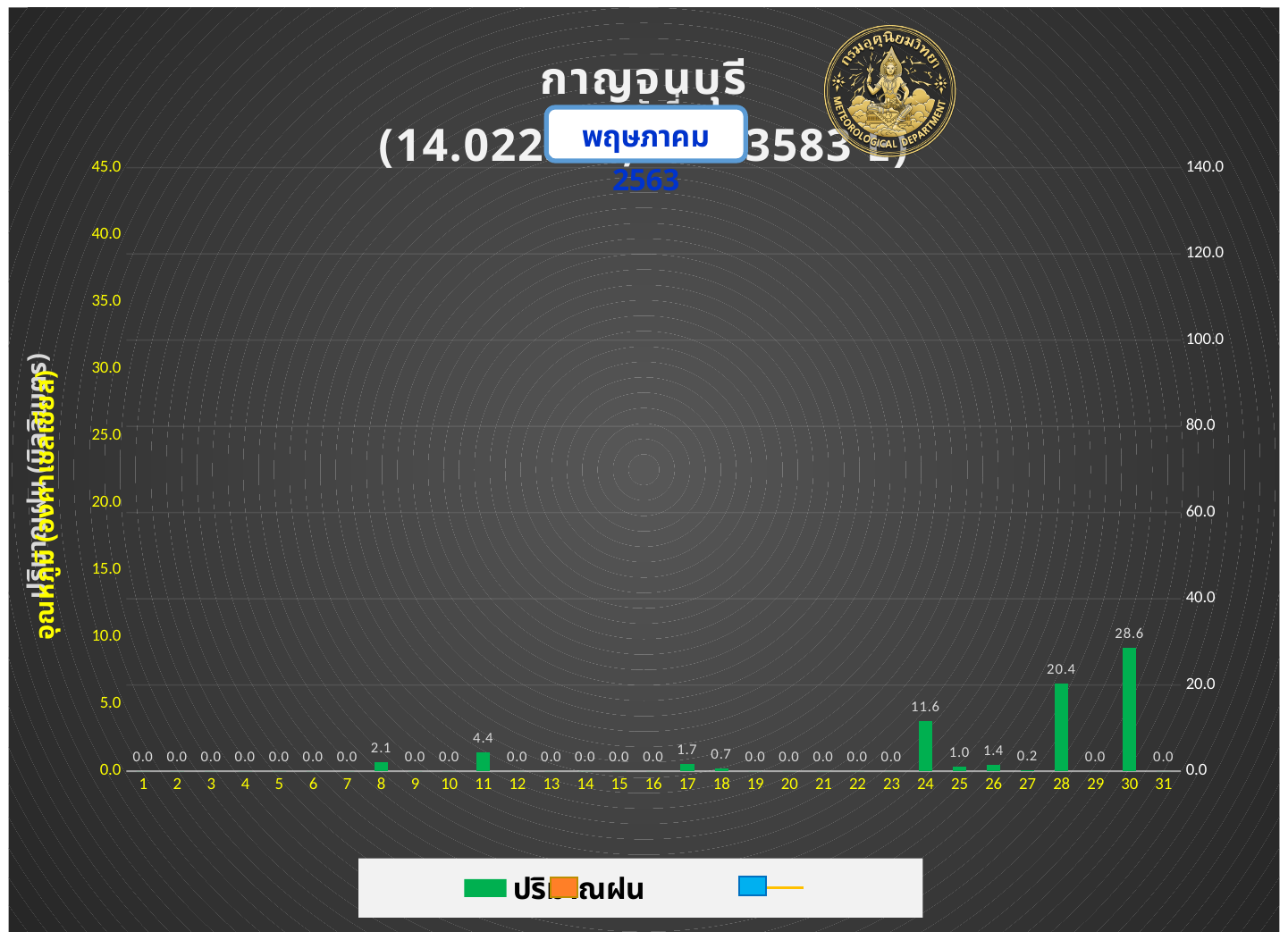
What is the difference between the rainfall values for day 30 and day 28? 8.2 How many days are shown on the x axis? 31 What is the rainfall value for day 24? 11.6 What is the rainfall value for day 28? 20.4 What is the rainfall value for day 11? 4.4 Which is larger, the rainfall value for day 17 or for day 18? day 17 What is the rainfall value for day 8? 2.1 What kind of chart is used to show the rainfall values? bar chart Which day has the highest rainfall value? 30 What is the rainfall value for day 30? 28.6 What is the difference between the rainfall values for day 24 and day 11? 7.2